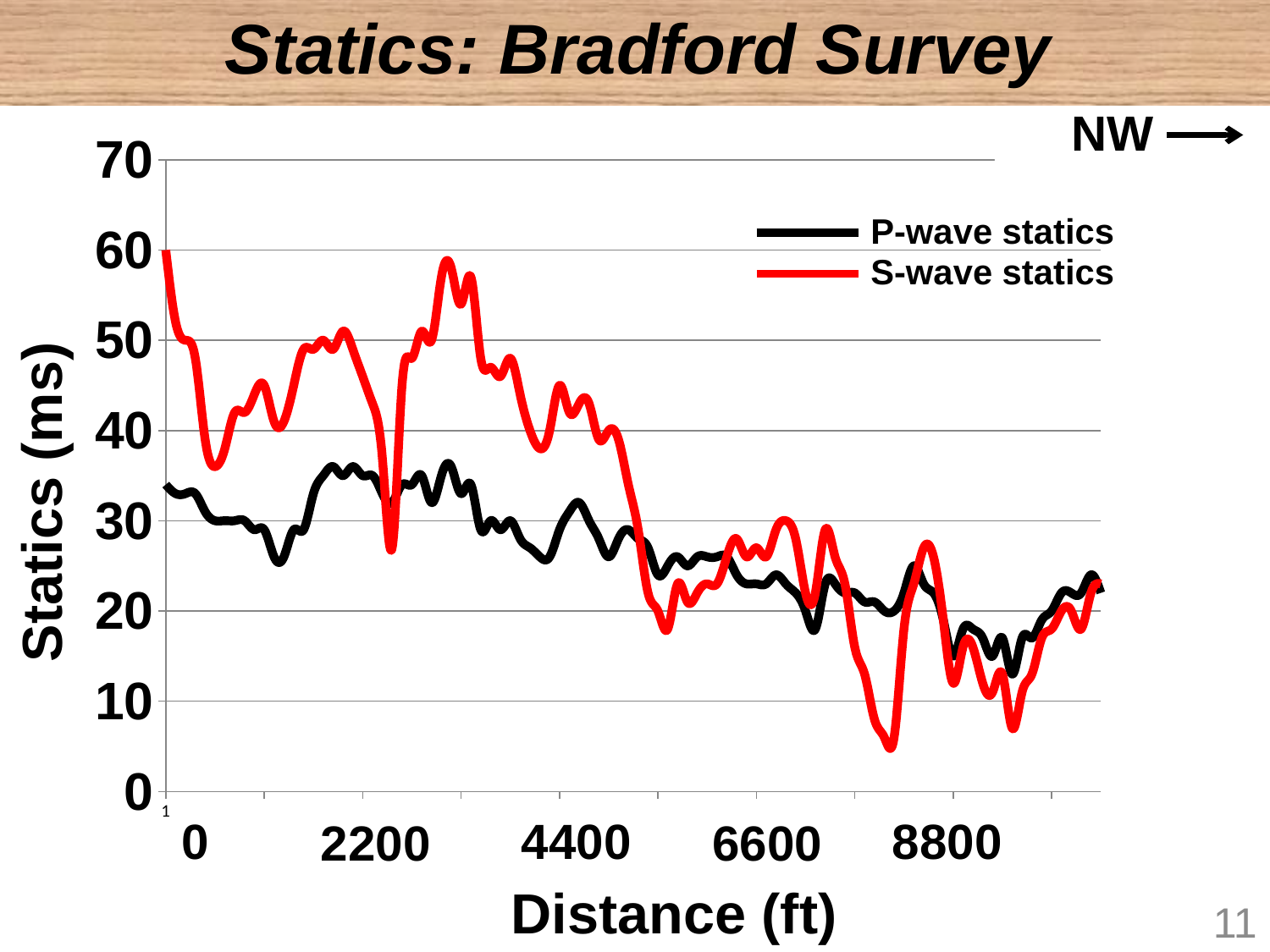
What is the title of the y axis? Statics (ms) Do the P-wave statics generally rise or fall as distance increases along the x axis? fall How many series does the legend list? 2 Is the P-wave statics value at a distance of 0 ft greater or less than 40? less Do the S-wave statics generally rise or fall as distance increases along the x axis? fall What kind of chart is shown on the slide? line chart At a distance of 2200 ft, which series has the larger statics value, P-wave statics or S-wave statics? S-wave statics Is the highest S-wave statics value on the chart greater or less than 50? greater Is the lowest S-wave statics value on the chart greater or less than 10? less Which series reaches the highest statics value anywhere on the chart? S-wave statics What are the two series named in the legend? P-wave statics and S-wave statics